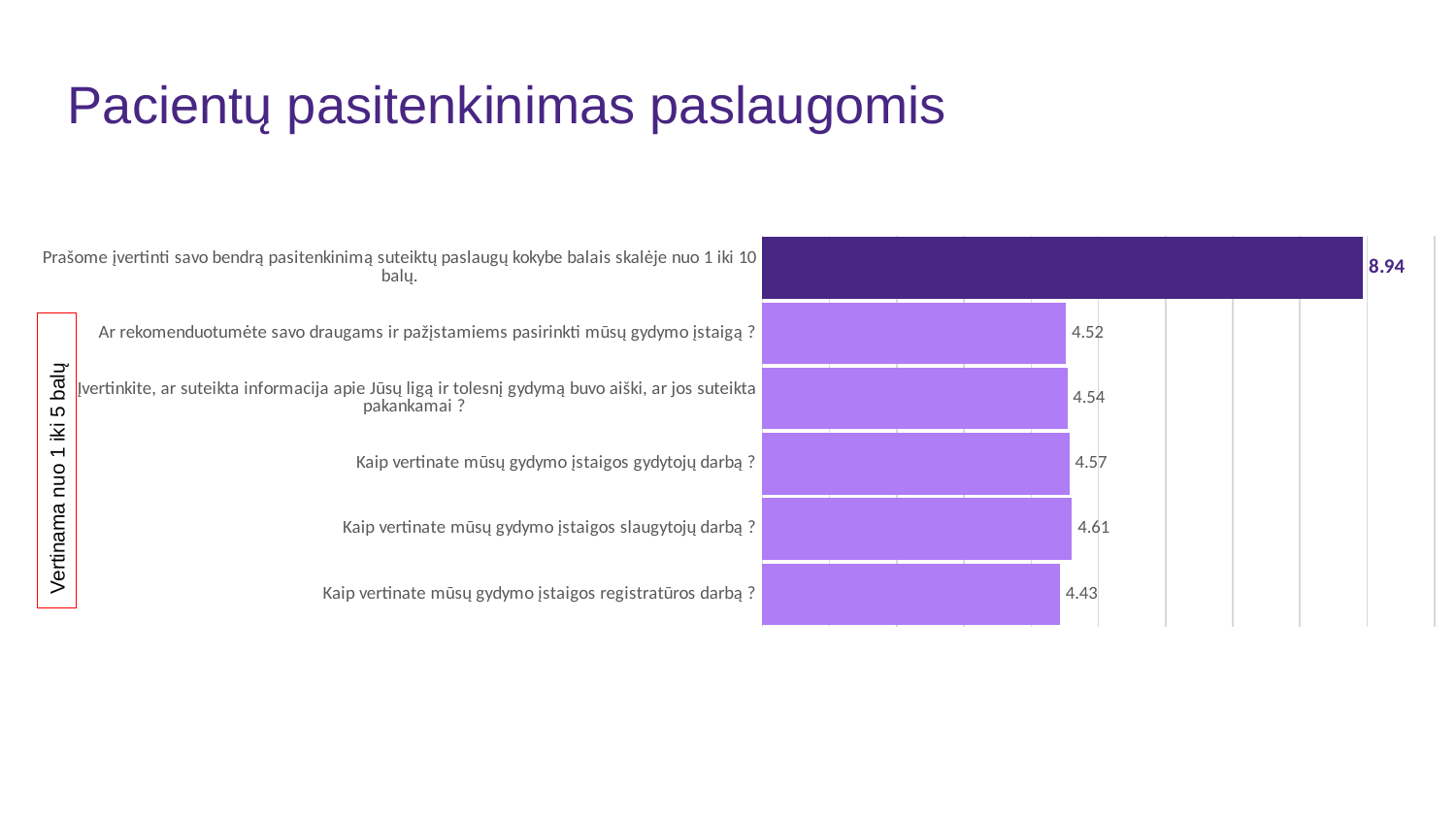
Which is larger: the value for gydytojų darbą or the value for slaugytojų darbą? slaugytojų darbą (4.61) What type of chart is shown on the slide? bar chart What is the value for the question about overall satisfaction rated on a scale from 1 to 10 ("Prašome įvertinti savo bendrą pasitenkinimą...")? 8.94 How many categories (bars) does the chart show? 6 Which category has the lowest value? Kaip vertinate mūsų gydymo įstaigos registratūros darbą ? What is the title of the slide containing the chart? Pacientų pasitenkinimas paslaugomis What is the value for "Kaip vertinate mūsų gydymo įstaigos registratūros darbą ?"? 4.43 What is the value for "Ar rekomenduotumėte savo draugams ir pažįstamiems pasirinkti mūsų gydymo įstaigą ?"? 4.52 Which category has the highest value? Prašome įvertinti savo bendrą pasitenkinimą suteiktų paslaugų kokybe balais skalėje nuo 1 iki 10 balų. What is the value for "Kaip vertinate mūsų gydymo įstaigos gydytojų darbą ?"? 4.57 What is the difference between the value for slaugytojų darbą (4.61) and registratūros darbą (4.43)? 0.18 What is the value for "Kaip vertinate mūsų gydymo įstaigos slaugytojų darbą ?"? 4.61